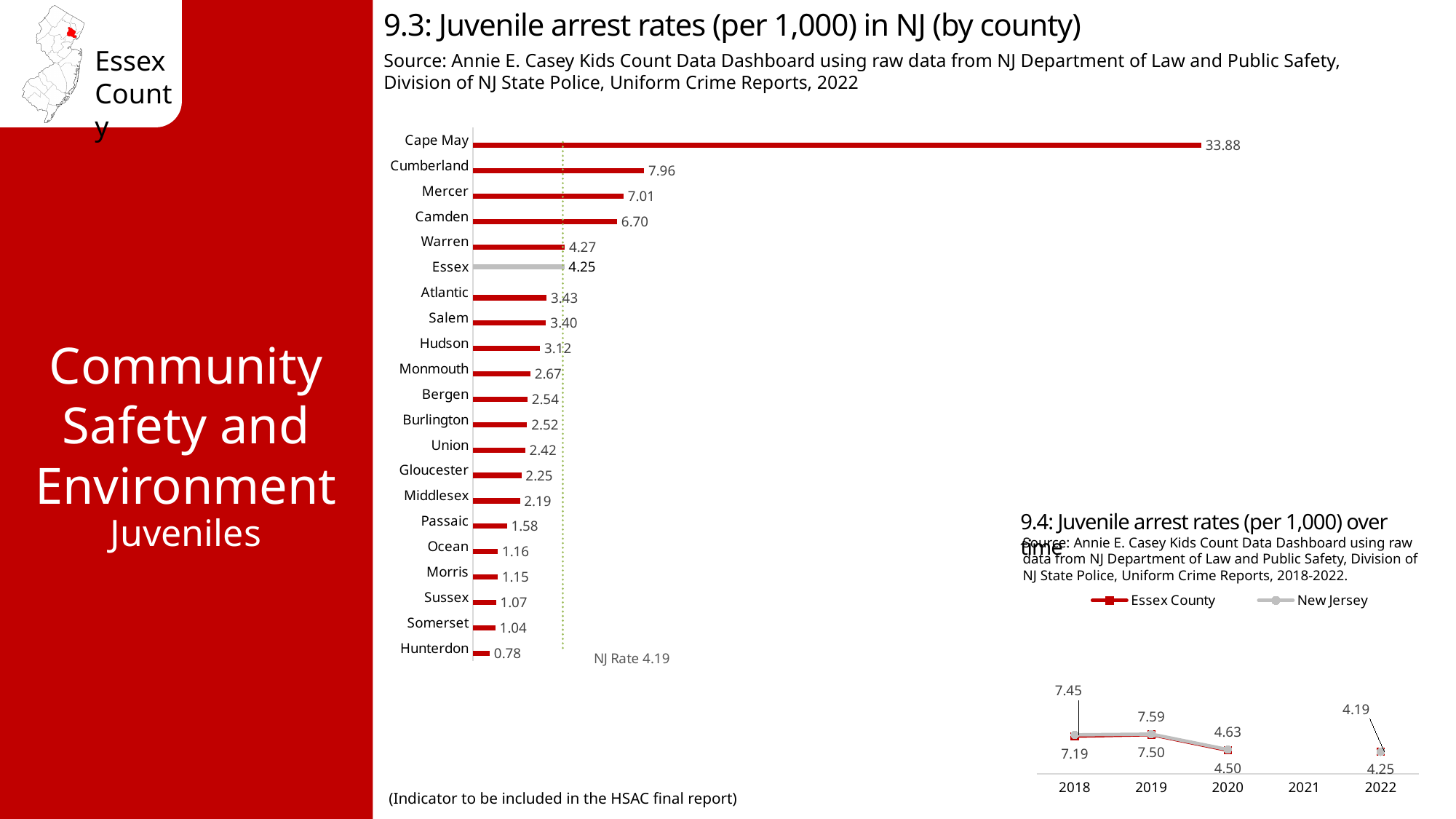
In chart 9.3 (juvenile arrest rates by county), how many counties are shown? 21 In chart 9.4 (juvenile arrest rates over time), how many series does the legend list? 2 In chart 9.3 (juvenile arrest rates by county), which is larger, the value for Camden or the value for Warren? Camden What kind of chart is chart 9.3 (juvenile arrest rates by county)? Bar chart In chart 9.3 (juvenile arrest rates by county), what is the difference between Cumberland and Mercer? 0.95 In chart 9.3 (juvenile arrest rates by county), which county has the highest rate? Cape May In chart 9.3 (juvenile arrest rates by county), what NJ rate is marked by the dotted reference line? 4.19 In chart 9.4 (juvenile arrest rates over time), what is the Essex County value for 2019? 7.50 In chart 9.3 (juvenile arrest rates by county), which county has the lowest rate? Hunterdon In chart 9.3 (juvenile arrest rates by county), what is the value for Cape May? 33.88 In chart 9.4 (juvenile arrest rates over time), does the New Jersey series rise or fall from 2019 to 2020? Fall In chart 9.3 (juvenile arrest rates by county), what is the value for Essex? 4.25